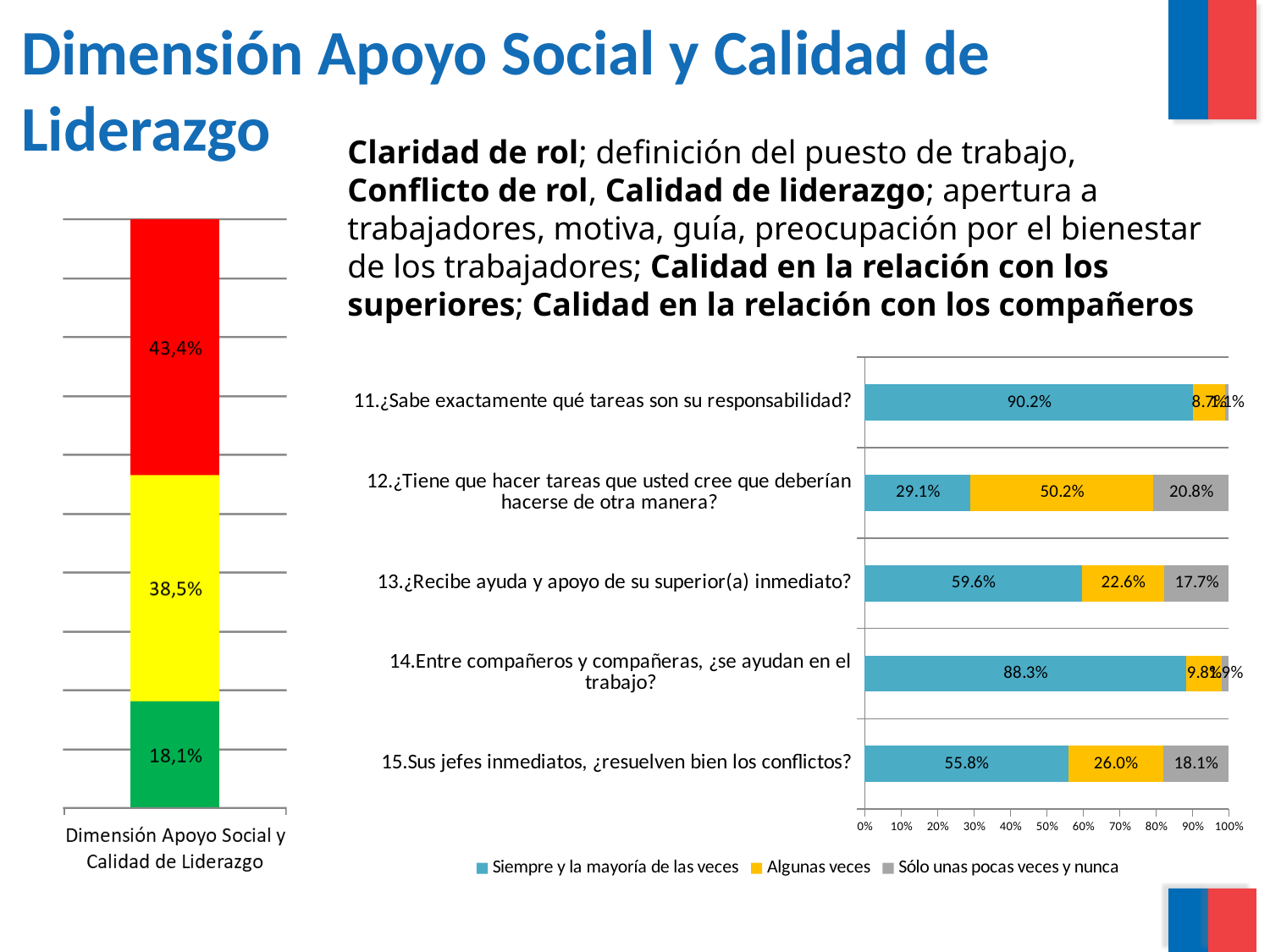
In the left chart (Dimensión Apoyo Social y Calidad de Liderazgo), which coloured segment has the largest value? Red In the right chart, which question has the lowest 'Siempre y la mayoría de las veces' percentage? 12.¿Tiene que hacer tareas que usted cree que deberían hacerse de otra manera? In the right chart, what percentage answered 'Algunas veces' for question 12 (¿Tiene que hacer tareas que usted cree que deberían hacerse de otra manera?)? 50.2% In the right chart, what is the difference between the 'Algunas veces' values for question 15 and question 13? 3.4% In the left chart (Dimensión Apoyo Social y Calidad de Liderazgo), what is the difference between the red segment and the yellow segment? 4,9% In the right chart, what percentage answered 'Sólo unas pocas veces y nunca' for question 15 (Sus jefes inmediatos, ¿resuelven bien los conflictos?)? 18.1% In the left chart (Dimensión Apoyo Social y Calidad de Liderazgo), what value is shown for the red segment? 43,4% How many questions (categories) are plotted in the right chart? 5 In the left chart (Dimensión Apoyo Social y Calidad de Liderazgo), what value is shown for the green segment? 18,1% How many series does the legend of the right chart list? 3 In the right chart, which is larger: the 'Siempre y la mayoría de las veces' value for question 13 or for question 15? Question 13 (59.6%) In the right chart, what percentage answered 'Siempre y la mayoría de las veces' for question 11 (¿Sabe exactamente qué tareas son su responsabilidad?)? 90.2%